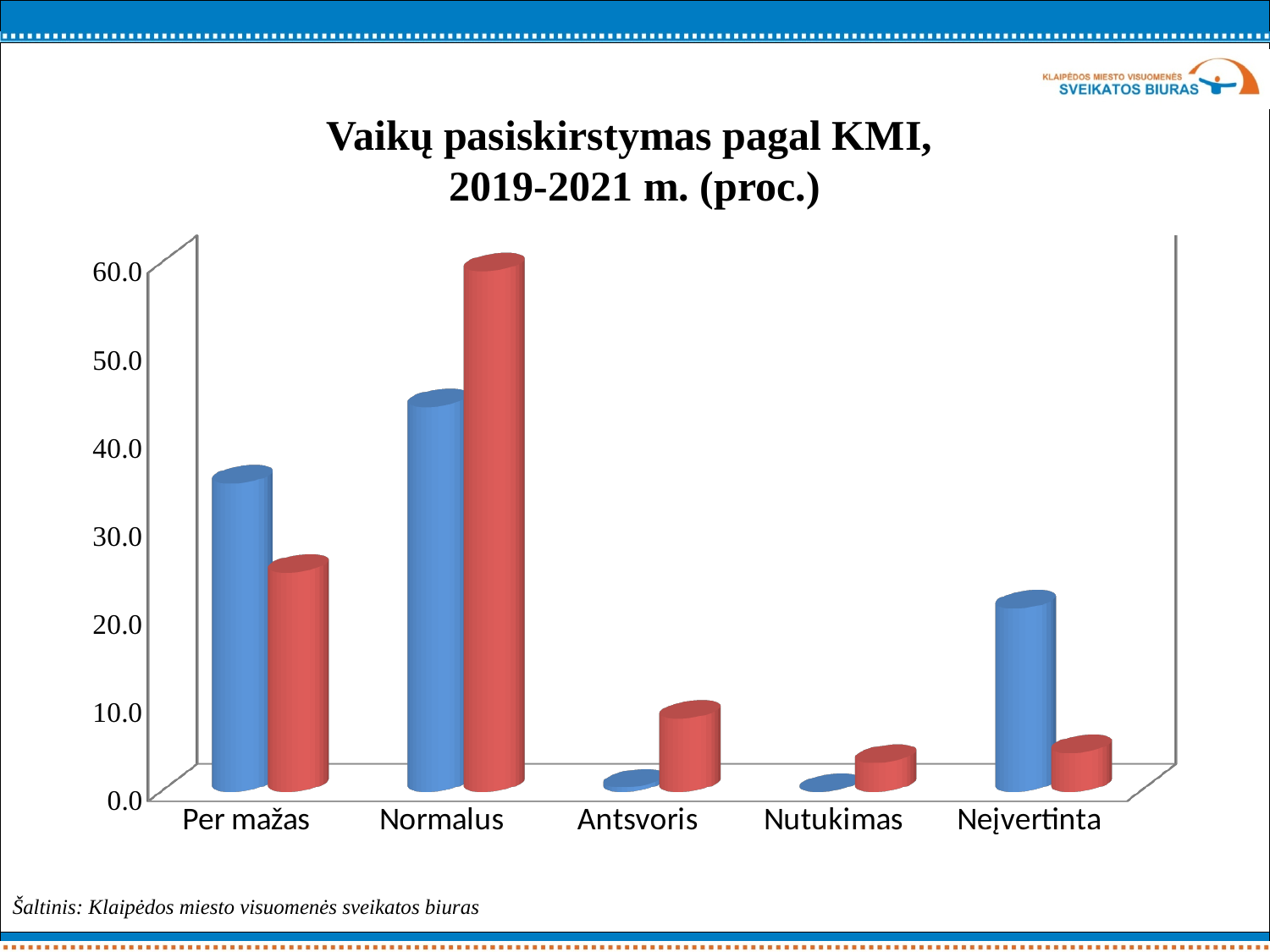
How many categories are shown on the x axis of the chart? 5 What kind of chart is shown on the slide? bar chart For Per mažas, which bar is taller, the blue one or the red one? the blue one Is the red bar for Antsvoris greater or less than 10.0? less Which category has the tallest red bar? Normalus Is the blue bar for Neįvertinta greater or less than 10.0? greater For Normalus, which bar is taller, the blue one or the red one? the red one Which category has the shortest red bar? Nutukimas Is the blue bar for Per mažas greater or less than 30.0? greater What is the title of the chart? Vaikų pasiskirstymas pagal KMI, 2019-2021 m. (proc.) Which category has the tallest blue bar? Normalus